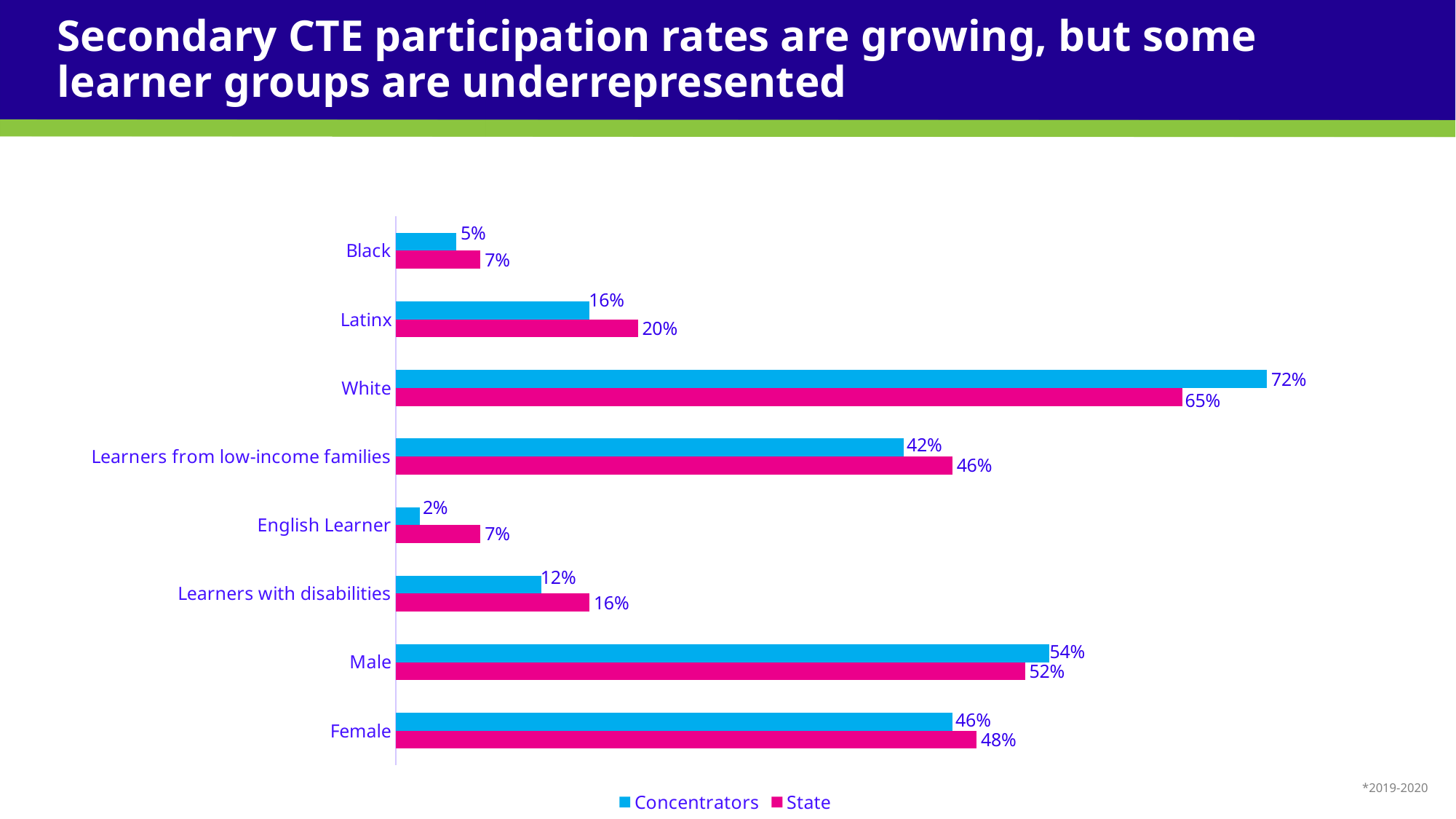
What kind of chart is shown on the slide? Bar chart What is the Concentrators value for English Learner? 2% What is the State value for Latinx? 20% Which category has the lowest Concentrators value? English Learner What is the Concentrators value for White? 72% How many series does the legend list? 2 Which is larger for Male: the Concentrators value or the State value? Concentrators Which series is shown in pink? State What is the State value for Learners from low-income families? 46% What is the difference between the State and Concentrators values for Learners with disabilities? 4% Which category has the highest Concentrators value? White How many categories are shown on the chart? 8